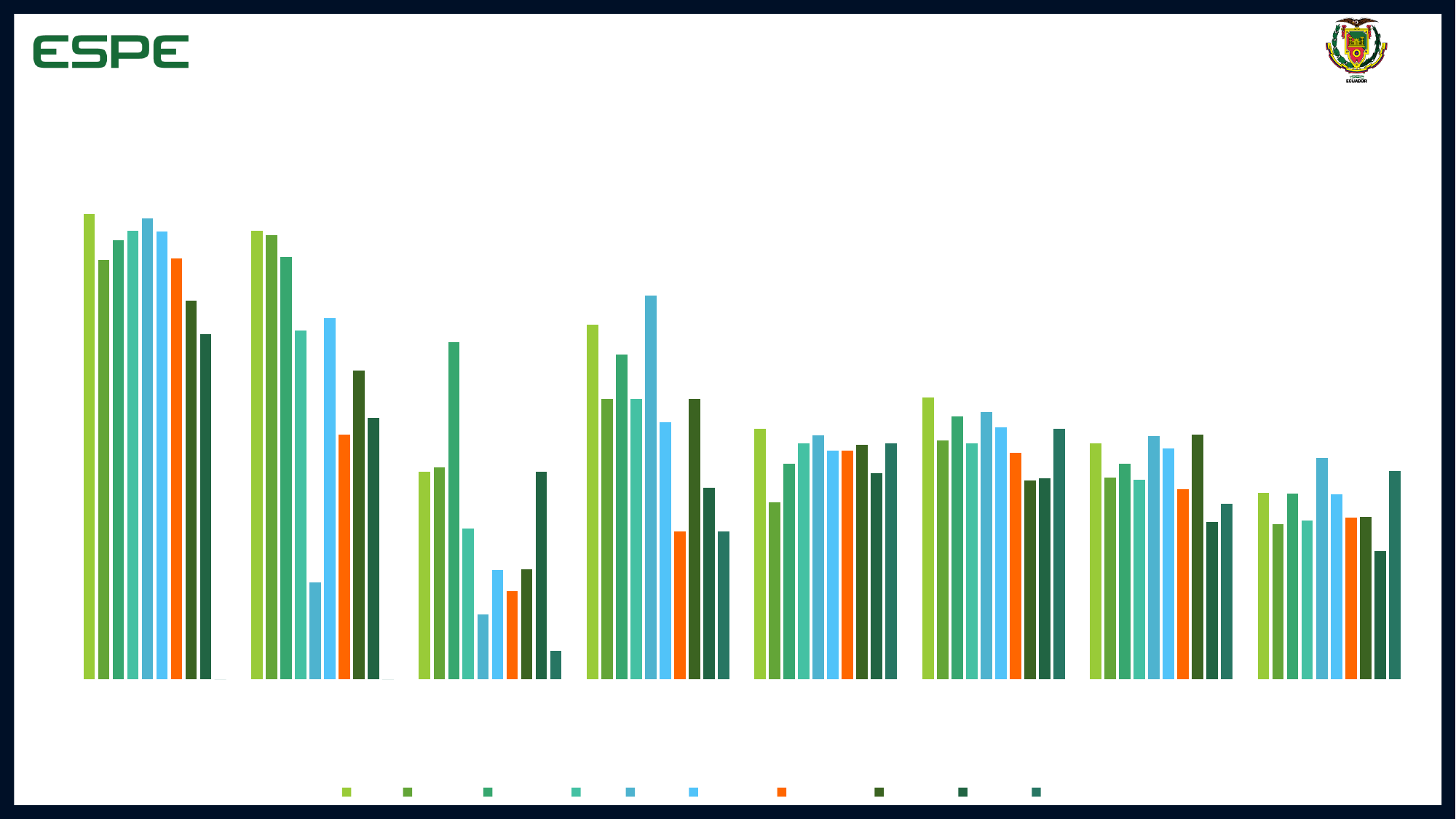
Are the bars on the chart vertical or horizontal? vertical How many series does the legend at the bottom of the chart list? 10 What colour is the seventh legend marker from the left? orange Do the bar heights generally rise or fall from the leftmost group to the rightmost group? fall Which group of bars, counting from the left, contains the tallest bar on the chart? the first group What kind of chart is shown on the slide? bar chart How many groups of bars (categories) are plotted along the x axis? 8